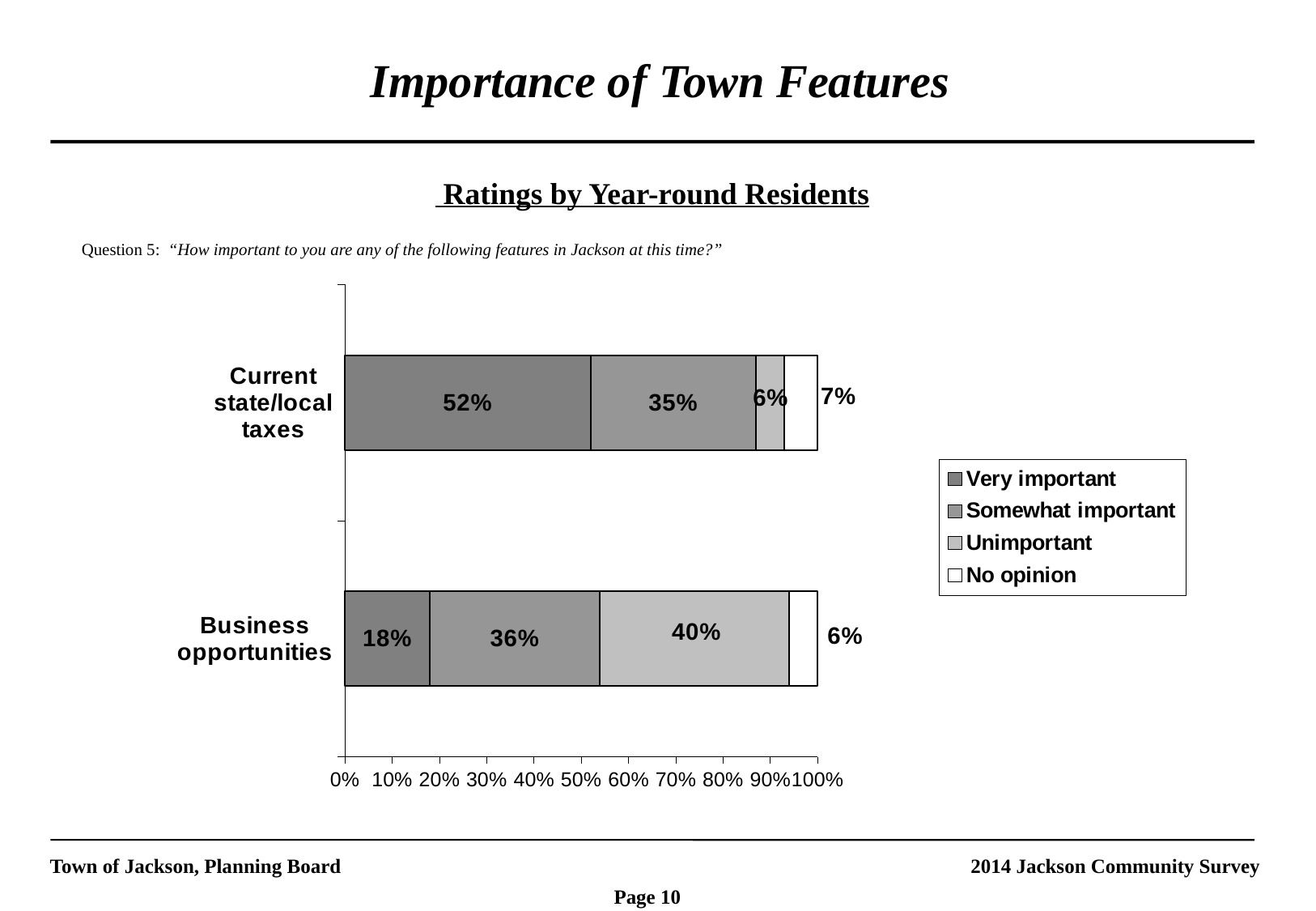
What is the 'No opinion' value for current state/local taxes? 7% What kind of chart is shown on the slide? Stacked bar chart Is the 'Unimportant' value larger for business opportunities or for current state/local taxes? Business opportunities What is the total of the stacked bar for current state/local taxes? 100% What is the 'Somewhat important' value for business opportunities? 36% What percentage of year-round residents rated current state/local taxes as very important? 52% What percentage of year-round residents rated business opportunities as unimportant? 40% How many features (categories) are shown in the chart? 2 What is the difference between the 'Very important' percentages for current state/local taxes and business opportunities? 34% Which feature has the lower 'Unimportant' percentage? Current state/local taxes Which feature has the higher 'Very important' percentage? Current state/local taxes How many series does the legend list? 4